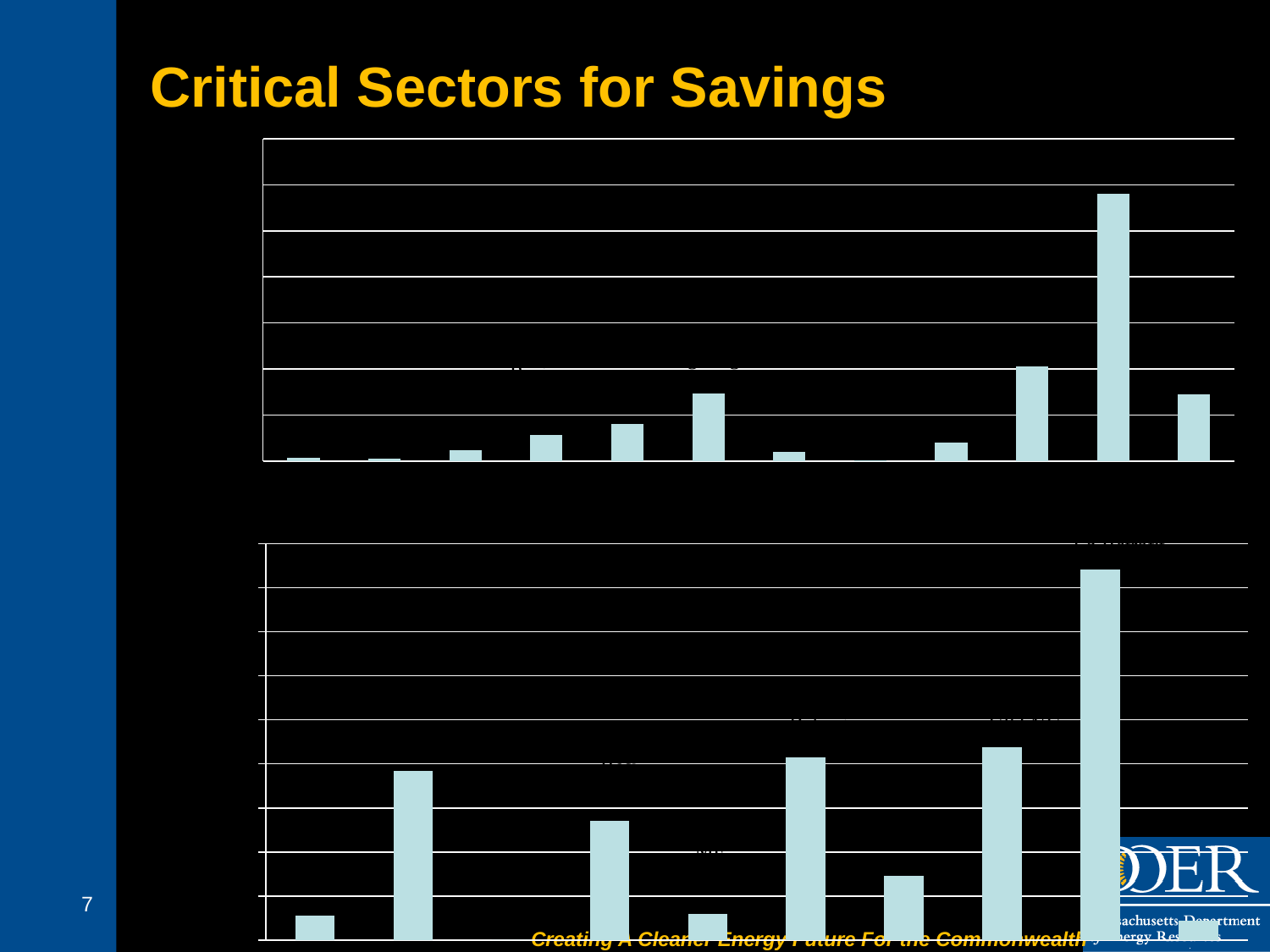
What colour are the bars in the charts? light blue How many charts are shown on the slide? 2 In the lower chart, which bar is the tallest, counting from the right? the second bar from the right In the upper chart, is the tallest bar on the left half or the right half of the chart? right half What kind of chart is the lower chart on the slide? bar chart What kind of chart is the upper chart on the slide? bar chart How many bars does the upper chart show? 12 In the lower chart, which is taller: the leftmost bar or the second bar from the left? the second bar from the left In the upper chart, which bar is the tallest, counting from the left? the 11th bar (second from the right) In the upper chart, which is taller: the rightmost bar or the second bar from the right? the second bar from the right